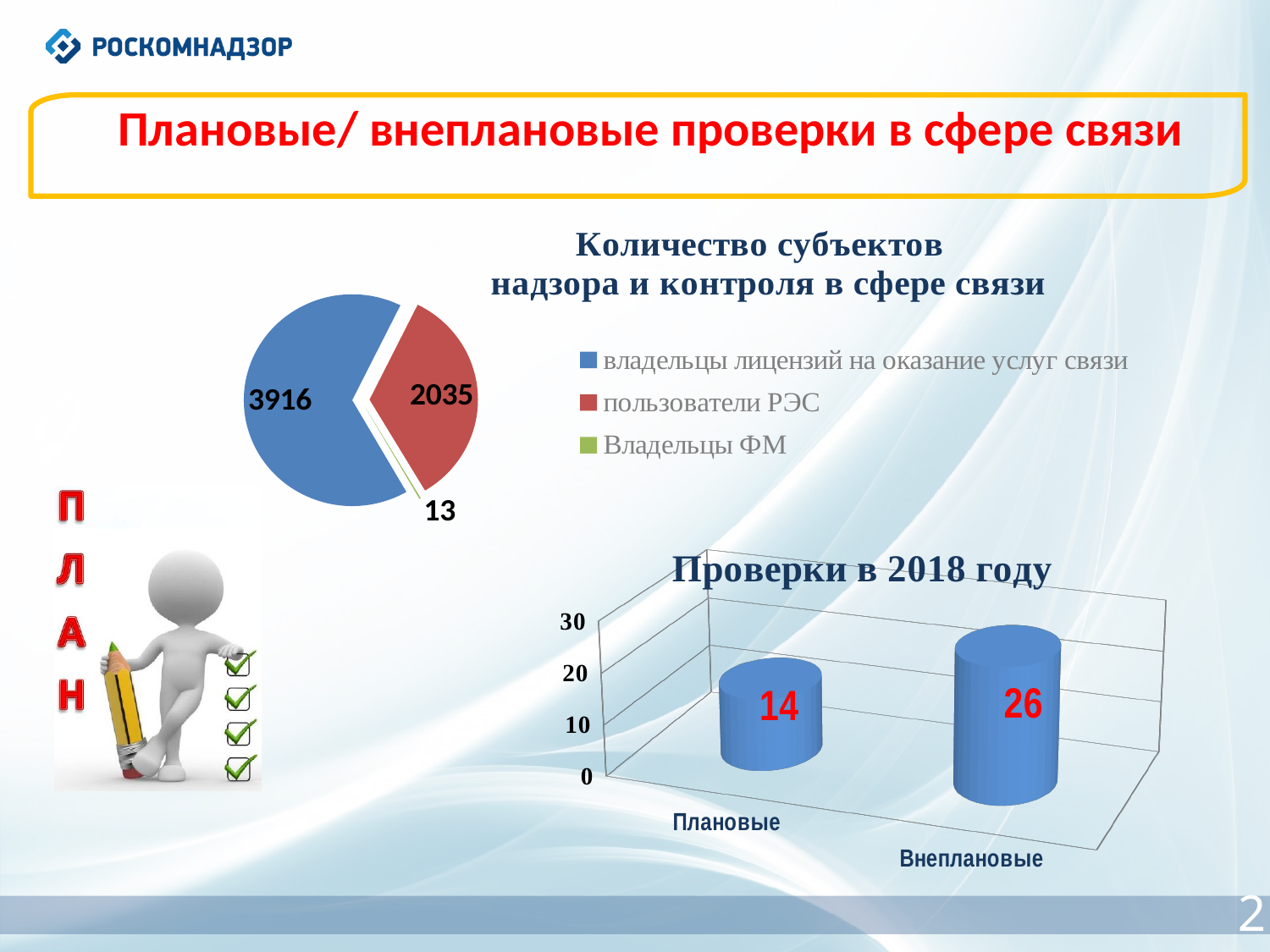
In the pie chart 'Количество субъектов надзора и контроля в сфере связи', what is the value for 'пользователи РЭС'? 2035 In the pie chart 'Количество субъектов надзора и контроля в сфере связи', what is the value for 'Владельцы ФМ'? 13 In the pie chart 'Количество субъектов надзора и контроля в сфере связи', which category has the largest value? владельцы лицензий на оказание услуг связи In the chart 'Проверки в 2018 году', what is the difference between 'Внеплановые' and 'Плановые'? 12 In the pie chart 'Количество субъектов надзора и контроля в сфере связи', what colour is the slice for 'пользователи РЭС'? Red In the pie chart 'Количество субъектов надзора и контроля в сфере связи', which category has the smallest value? Владельцы ФМ How many categories does the legend of the pie chart 'Количество субъектов надзора и контроля в сфере связи' list? 3 In the chart 'Проверки в 2018 году', what is the value for 'Плановые'? 14 In the pie chart 'Количество субъектов надзора и контроля в сфере связи', what is the value for 'владельцы лицензий на оказание услуг связи'? 3916 What kind of chart is 'Проверки в 2018 году'? Bar chart In the chart 'Проверки в 2018 году', what is the value for 'Внеплановые'? 26 In the pie chart 'Количество субъектов надзора и контроля в сфере связи', what is the difference between the values for 'владельцы лицензий на оказание услуг связи' and 'пользователи РЭС'? 1881